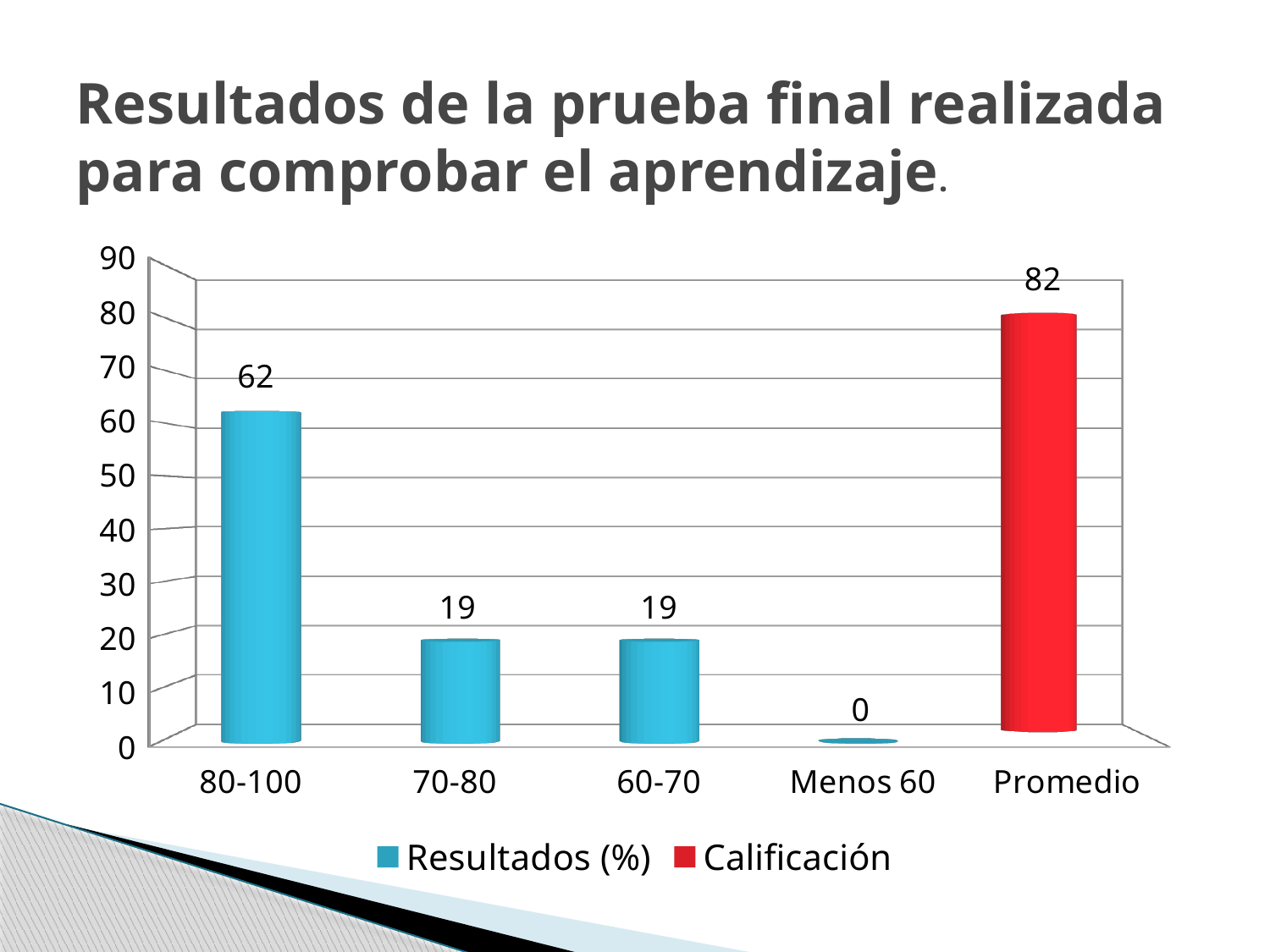
What is the value shown for Promedio? 82 What is the difference between the values for 80-100 and 70-80? 43 What is the value for the 80-100 category? 62 How many series does the legend list? 2 Which is larger, the value for 80-100 or the value for Promedio? Promedio Which category has the lowest value on the chart? Menos 60 What colour is the bar for the Calificación series? Red Which category has the highest value on the chart? Promedio What is the value for the 70-80 category? 19 What kind of chart is shown on the slide? Bar chart How many categories are shown on the x axis? 5 What is the value for the Menos 60 category? 0